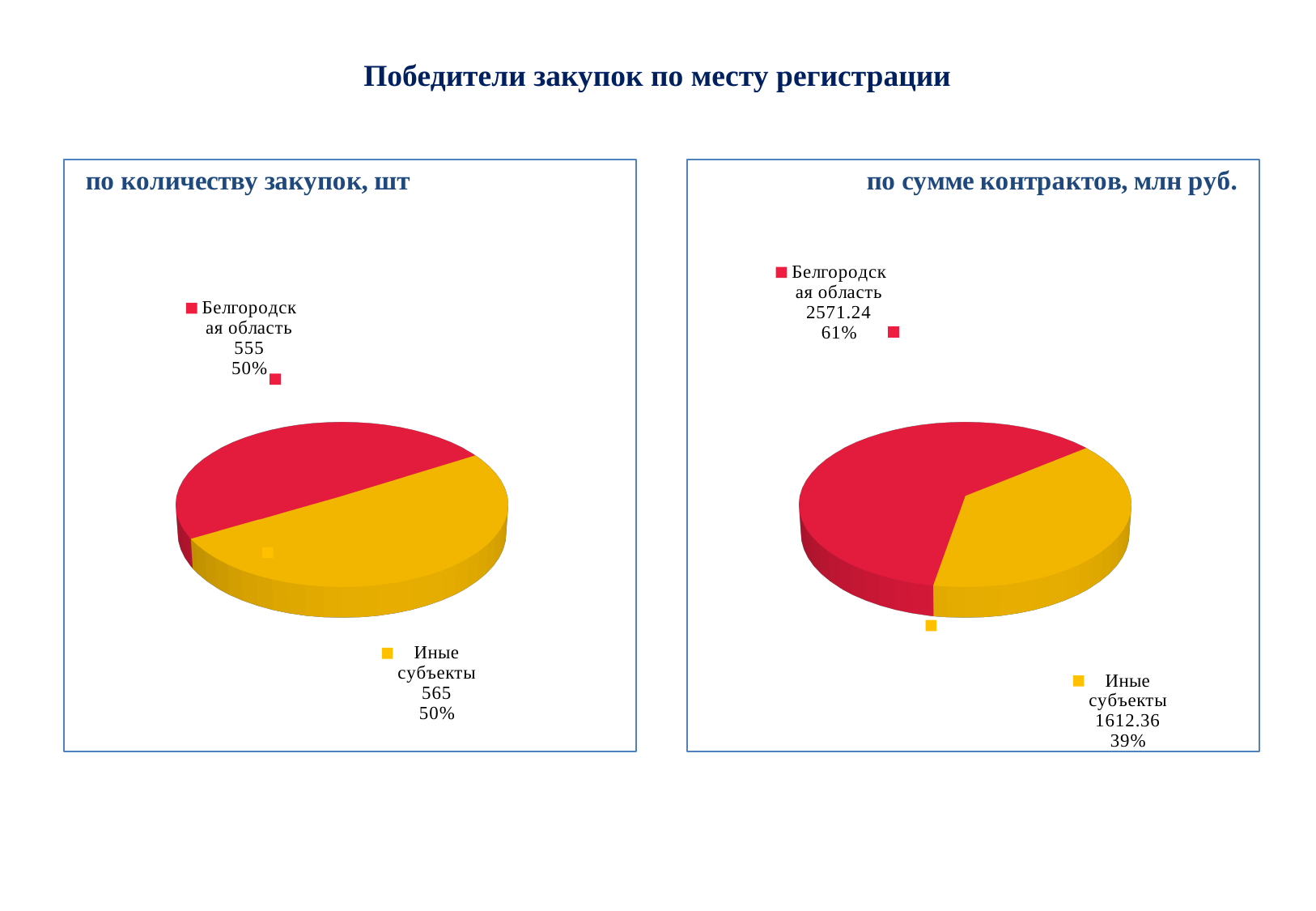
In the chart titled 'по количеству закупок, шт', what is the value for Иные субъекты? 565 In the chart titled 'по сумме контрактов, млн руб.', what is the value for Белгородская область? 2571.24 In the chart titled 'по количеству закупок, шт', what is the difference between the values for Иные субъекты and Белгородская область? 10 In the chart titled 'по количеству закупок, шт', what share of the pie does Иные субъекты have? 50% In the chart titled 'по сумме контрактов, млн руб.', which category has the largest slice? Белгородская область In the chart titled 'по сумме контрактов, млн руб.', what is the difference between the values for Белгородская область and Иные субъекты? 958.88 In the chart titled 'по сумме контрактов, млн руб.', what share of the pie does Иные субъекты have? 39% How many categories does the chart titled 'по сумме контрактов, млн руб.' show? 2 In the chart titled 'по количеству закупок, шт', what is the value for Белгородская область? 555 In the chart titled 'по сумме контрактов, млн руб.', what share of the pie does Белгородская область have? 61% In the chart titled 'по сумме контрактов, млн руб.', what is the value for Иные субъекты? 1612.36 What kind of chart is the chart titled 'по количеству закупок, шт'? Pie chart